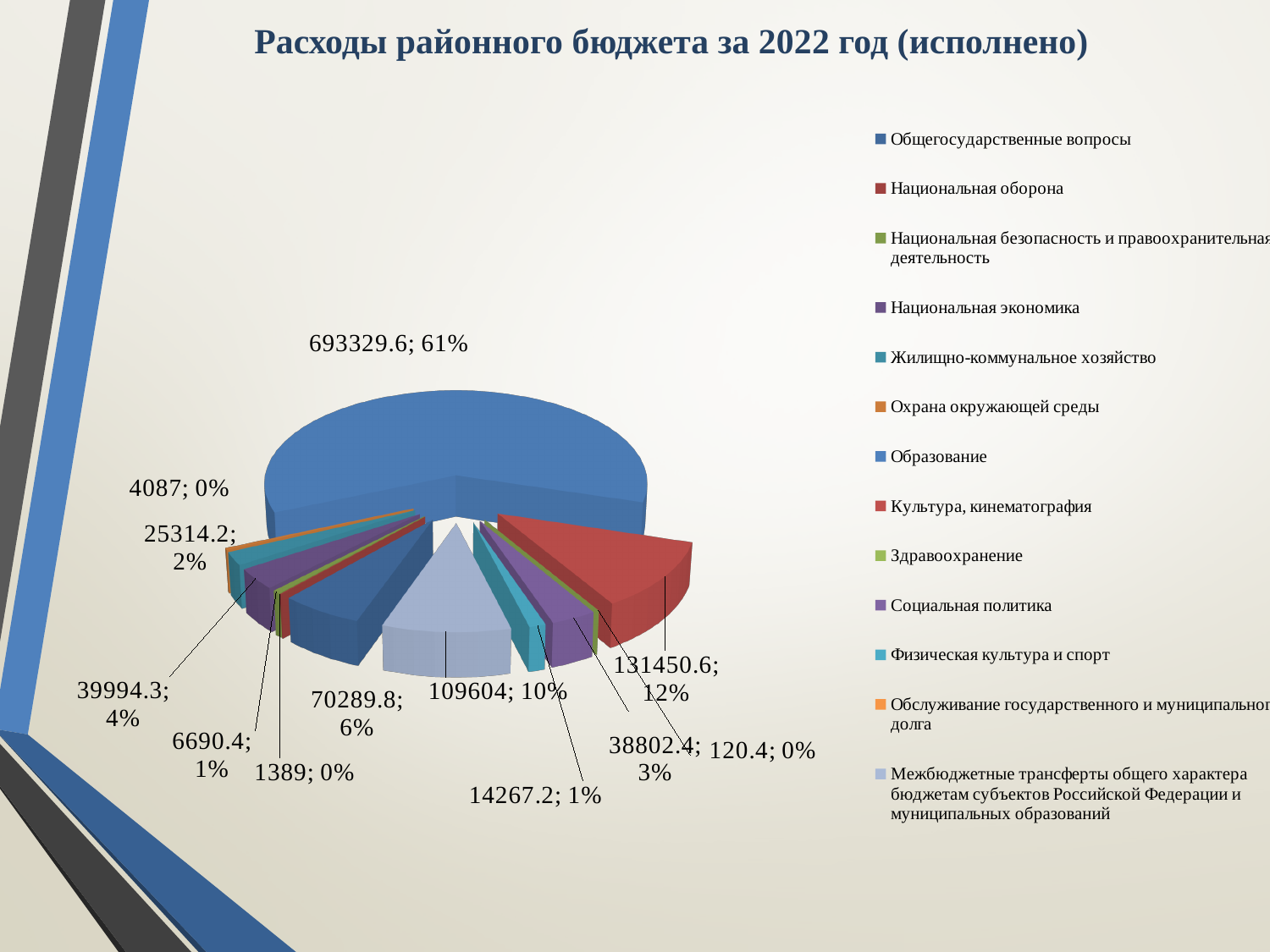
What kind of chart is shown on the slide? pie chart Which category has the largest slice of the pie? Образование How many slices are labelled with a share of 0%? 3 What share of the pie does Общегосударственные вопросы take? 6% What share of the pie does Культура, кинематография take? 12% What share of the pie does Образование take? 61% What is the title of the chart? Расходы районного бюджета за 2022 год (исполнено) What is the value shown for Образование? 693329.6 What is the value shown for Культура, кинематография? 131450.6 What is the difference between the values for Образование and Культура, кинематография? 561879 How many categories does the legend list? 13 Which is larger: the slice for Культура, кинематография or the slice for Межбюджетные трансферты общего характера бюджетам субъектов Российской Федерации и муниципальных образований? Культура, кинематография